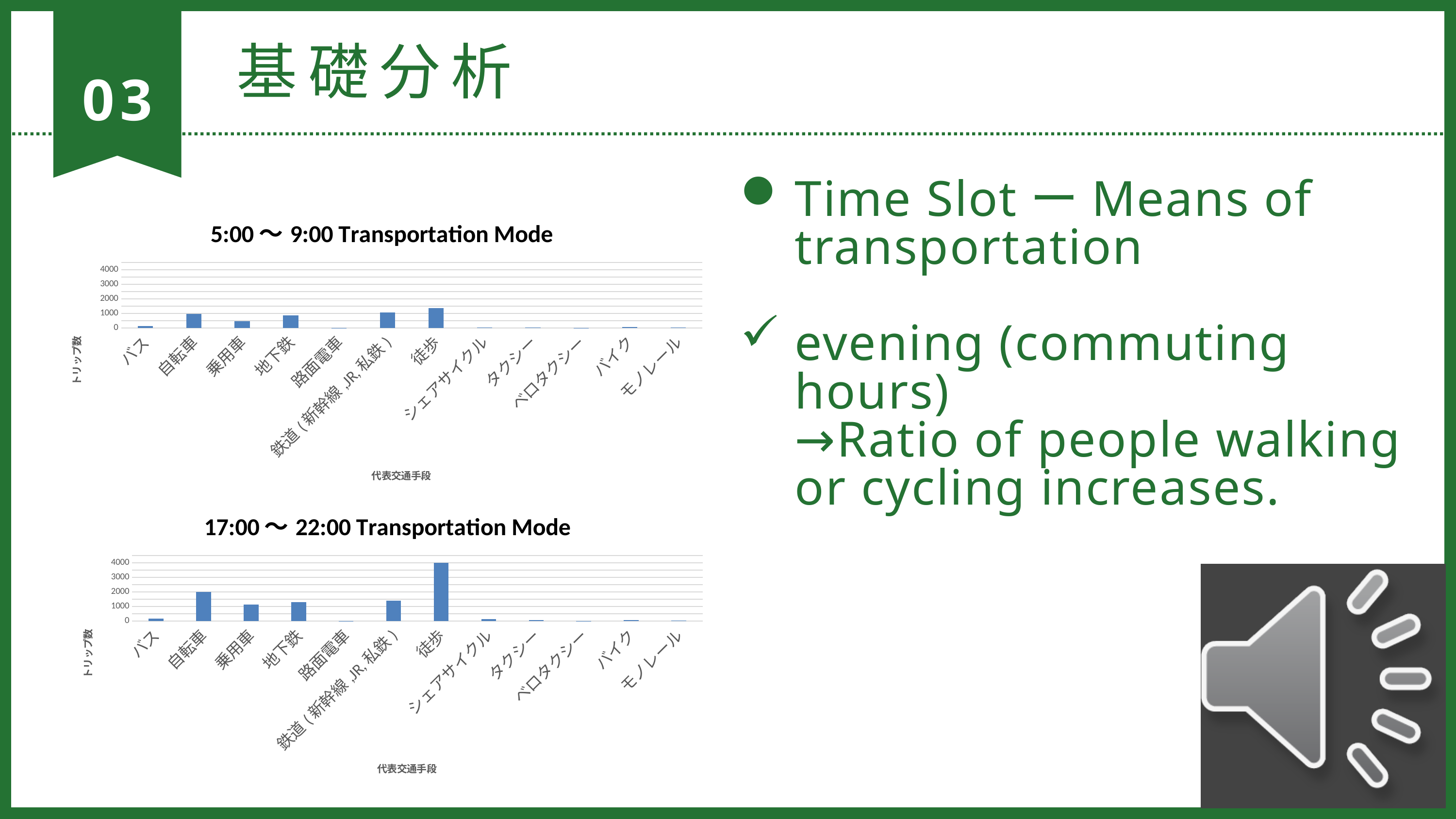
In the "17:00 〜 22:00 Transportation Mode" chart, which is larger, the value for 自転車 or the value for 鉄道 ( 新幹線 ,JR, 私鉄 )? 自転車 In the "5:00 〜 9:00 Transportation Mode" chart, which is larger, the value for 自転車 or the value for 乗用車? 自転車 What kind of chart is the "5:00 〜 9:00 Transportation Mode" chart? bar chart In the "5:00 〜 9:00 Transportation Mode" chart, is the value for 乗用車 greater or less than 1000? less In the "17:00 〜 22:00 Transportation Mode" chart, is the value for 徒歩 greater or less than 3000? greater In the "17:00 〜 22:00 Transportation Mode" chart, is the value for バス greater or less than 1000? less What is the y-axis title of the "5:00 〜 9:00 Transportation Mode" chart? トリップ数 In the "17:00 〜 22:00 Transportation Mode" chart, which transportation mode has the highest value? 徒歩 How many transportation mode categories are shown on the x axis of the "17:00 〜 22:00 Transportation Mode" chart? 12 In the "5:00 〜 9:00 Transportation Mode" chart, which transportation mode has the highest value? 徒歩